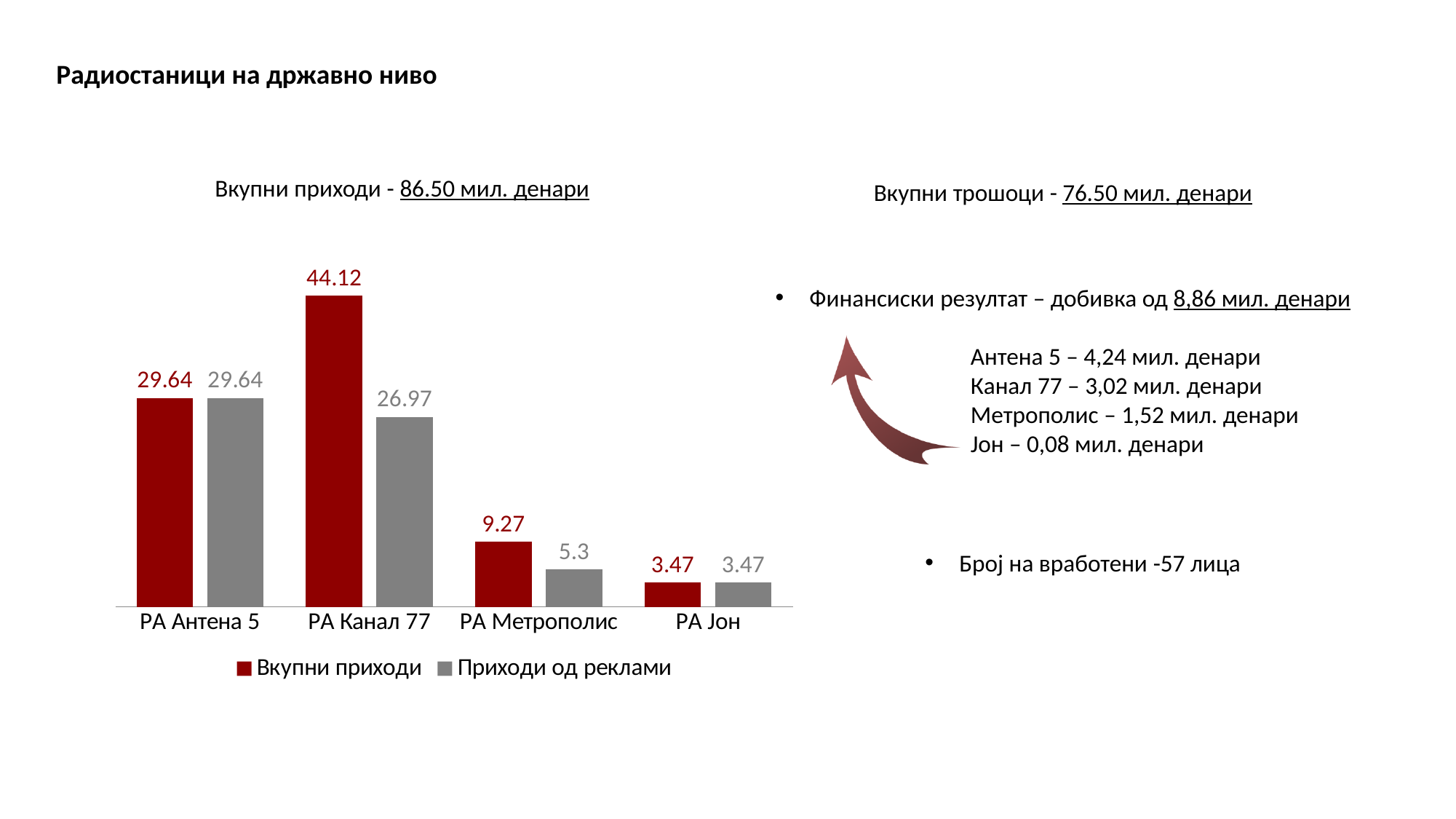
What is the value of Вкупни приходи for РА Јон? 3.47 Which is larger: Вкупни приходи for РА Антена 5 or Приходи од реклами for РА Канал 77? Вкупни приходи for РА Антена 5 How many categories are shown on the x axis of the chart? 4 What is the difference between Вкупни приходи and Приходи од реклами for РА Метрополис? 3.97 What is the value of Приходи од реклами for РА Метрополис? 5.3 What kind of chart is shown on the slide? Bar chart How many series does the legend list? 2 What is the difference between Вкупни приходи and Приходи од реклами for РА Канал 77? 17.15 What is the value of Приходи од реклами for РА Канал 77? 26.97 Which category has the highest Вкупни приходи? РА Канал 77 Which category has the lowest Приходи од реклами? РА Јон What is the value of Вкупни приходи for РА Канал 77? 44.12